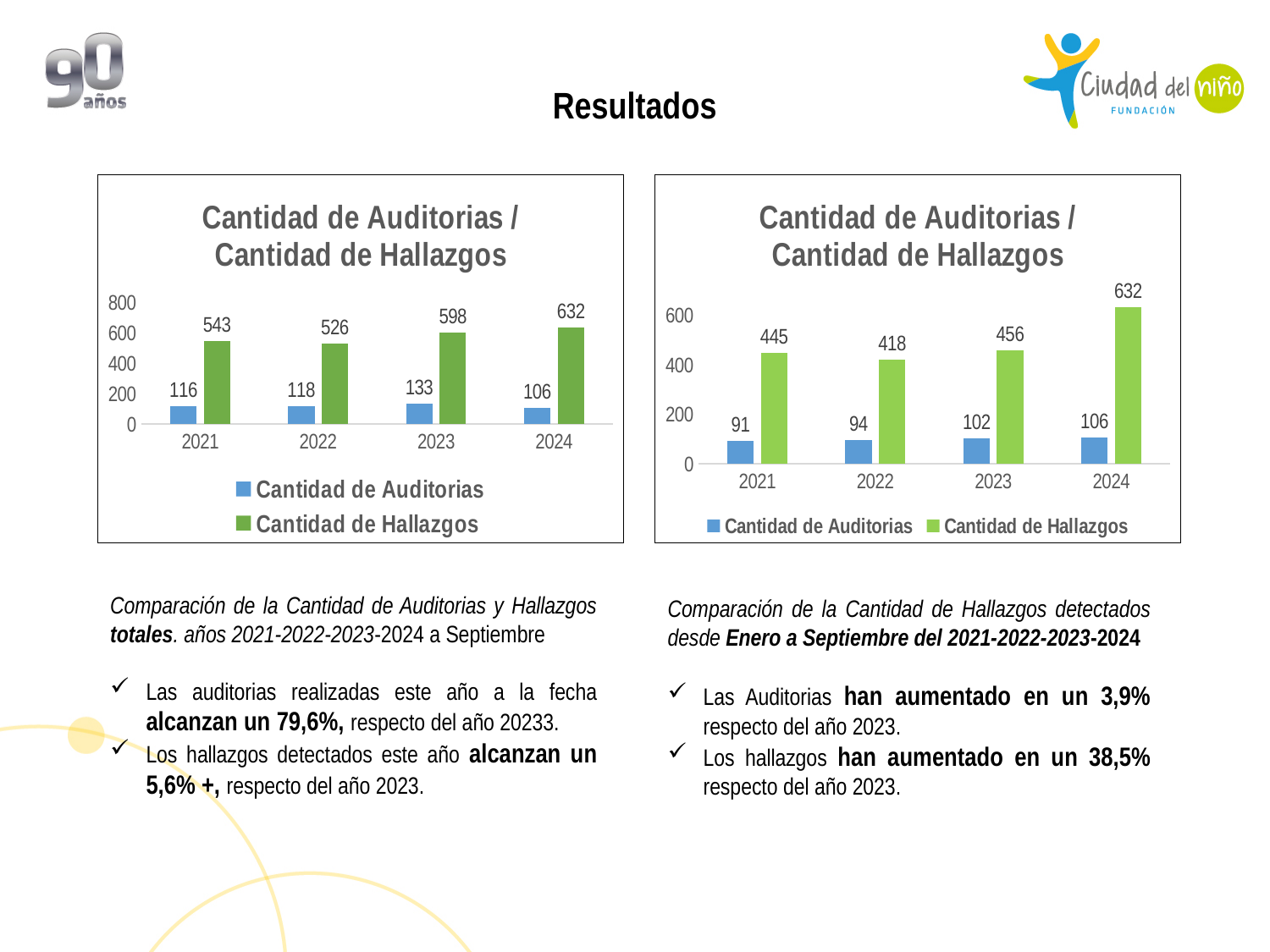
In the right chart, what is the value of Cantidad de Hallazgos for 2022? 418 In the left chart, which year has the lowest Cantidad de Auditorias? 2024 In the right chart, do the Cantidad de Auditorias values rise or fall from 2021 to 2024? rise How many series does the legend of the left chart list? 2 In the right chart, what is the value of Cantidad de Auditorias for 2024? 106 In the left chart, what is the difference between Cantidad de Auditorias in 2023 and 2022? 15 In the right chart, what is the difference between Cantidad de Hallazgos in 2024 and 2023? 176 In the left chart, what is the value of Cantidad de Auditorias for 2021? 116 In the right chart, which year has the lowest Cantidad de Hallazgos? 2022 In the right chart, is Cantidad de Auditorias higher in 2023 or in 2021? 2023 In the left chart, which year has the highest Cantidad de Hallazgos? 2024 In the left chart, what is the value of Cantidad de Hallazgos for 2023? 598